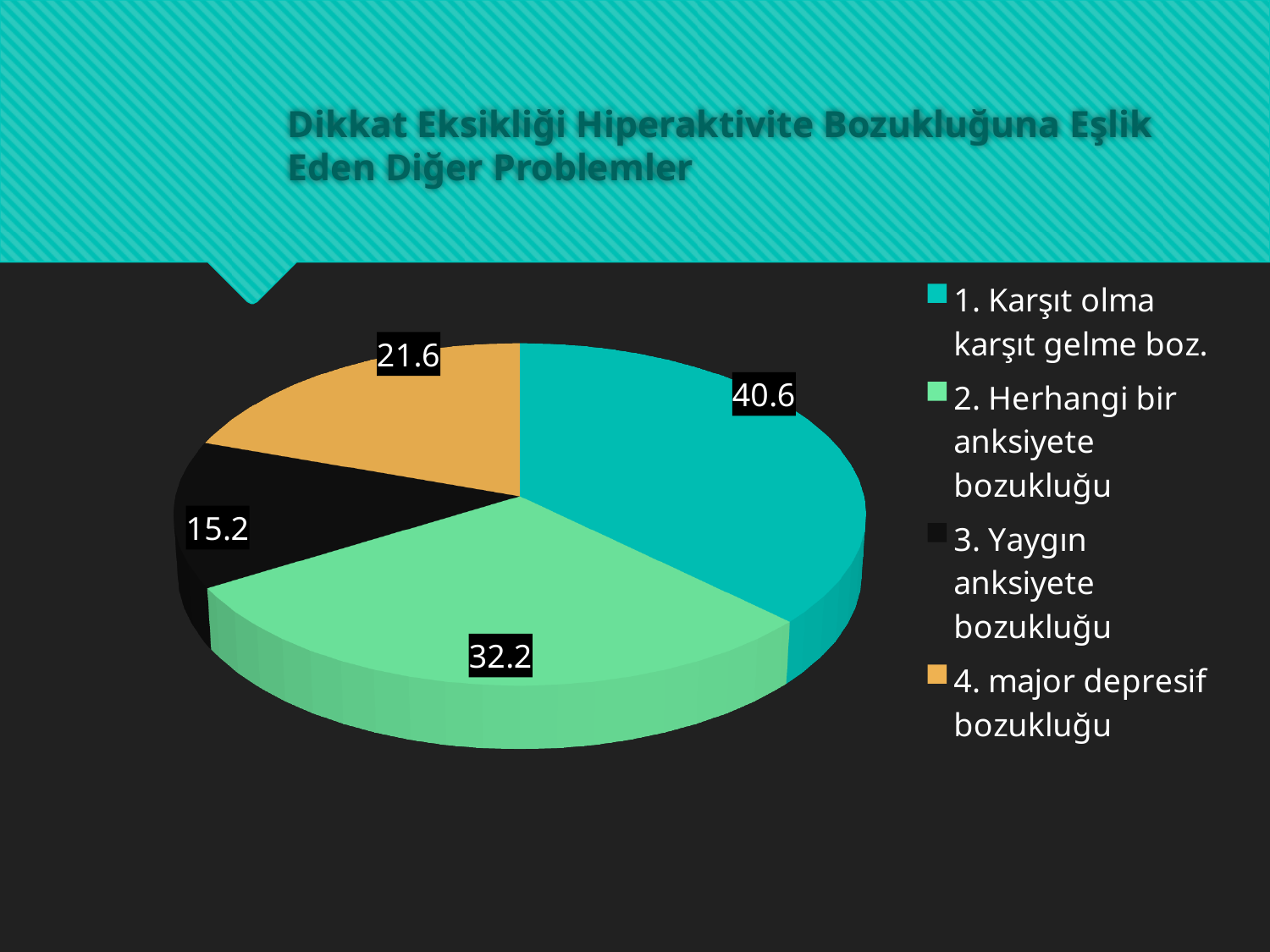
Which is larger: the value for "4. major depresif bozukluğu" or "3. Yaygın anksiyete bozukluğu"? 4. major depresif bozukluğu What colour is the slice for "4. major depresif bozukluğu"? orange What is the difference between the values for "4. major depresif bozukluğu" and "3. Yaygın anksiyete bozukluğu"? 6.4 What is the value for "1. Karşıt olma karşıt gelme boz."? 40.6 What is the value for "3. Yaygın anksiyete bozukluğu"? 15.2 What type of chart is shown on the slide? pie chart Which category has the largest slice? 1. Karşıt olma karşıt gelme boz. What is the difference between the values for "1. Karşıt olma karşıt gelme boz." and "2. Herhangi bir anksiyete bozukluğu"? 8.4 What is the value for "4. major depresif bozukluğu"? 21.6 Which category has the smallest slice? 3. Yaygın anksiyete bozukluğu How many categories does the pie chart have? 4 What is the value for "2. Herhangi bir anksiyete bozukluğu"? 32.2